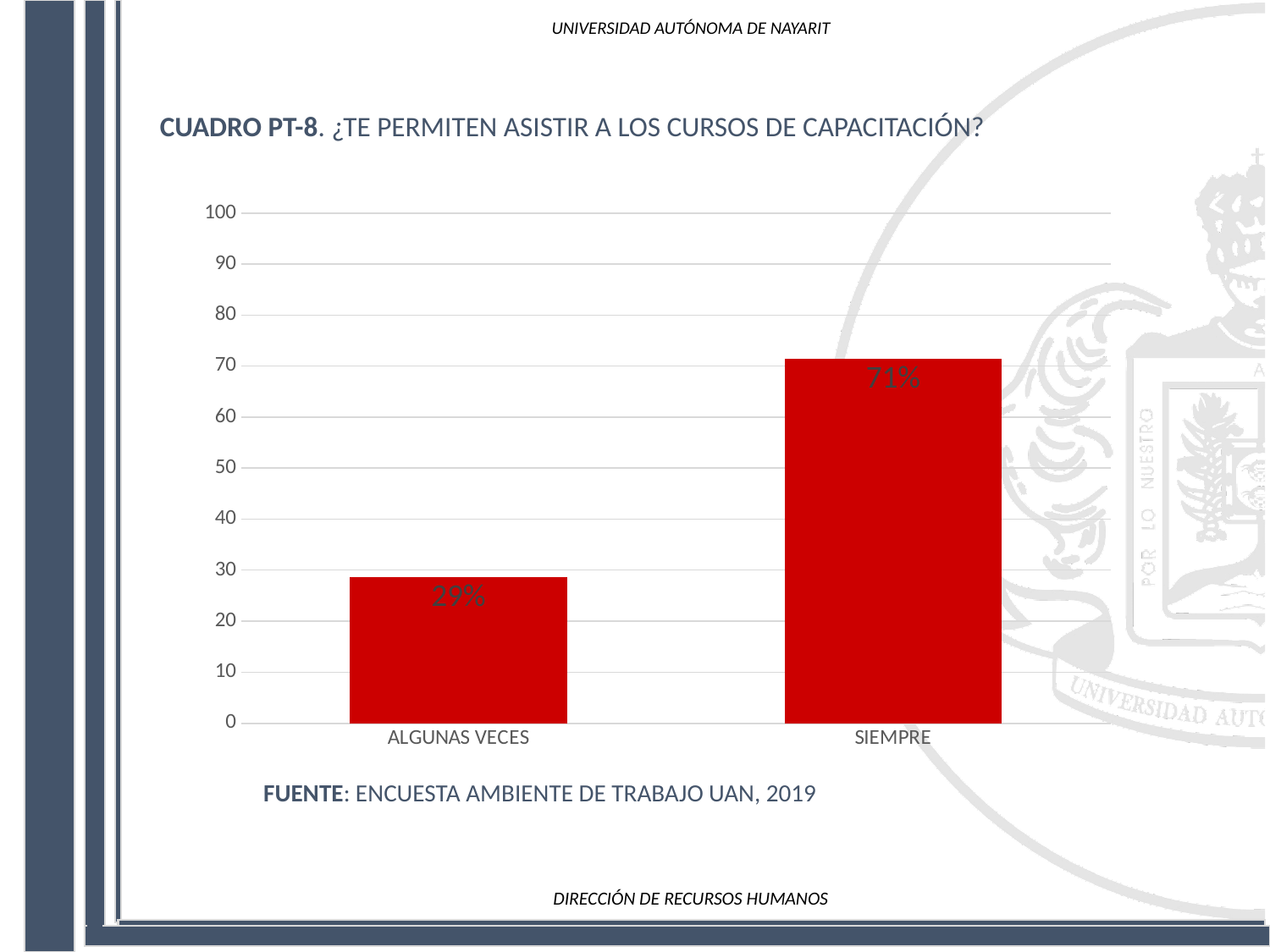
What is the value for ALGUNAS VECES? 29% What is the title of the chart? CUADRO PT-8. ¿TE PERMITEN ASISTIR A LOS CURSOS DE CAPACITACIÓN? What is the difference between the values for SIEMPRE and ALGUNAS VECES? 42% Is the value for ALGUNAS VECES greater or less than 40? less What kind of chart is shown on the slide? bar chart How many categories are shown on the x axis? 2 What source is cited below the chart? ENCUESTA AMBIENTE DE TRABAJO UAN, 2019 Which is larger, the value for ALGUNAS VECES or the value for SIEMPRE? SIEMPRE Is the value for SIEMPRE greater or less than 60? greater Which category has the lowest value? ALGUNAS VECES Which category has the highest value? SIEMPRE What is the value for SIEMPRE? 71%